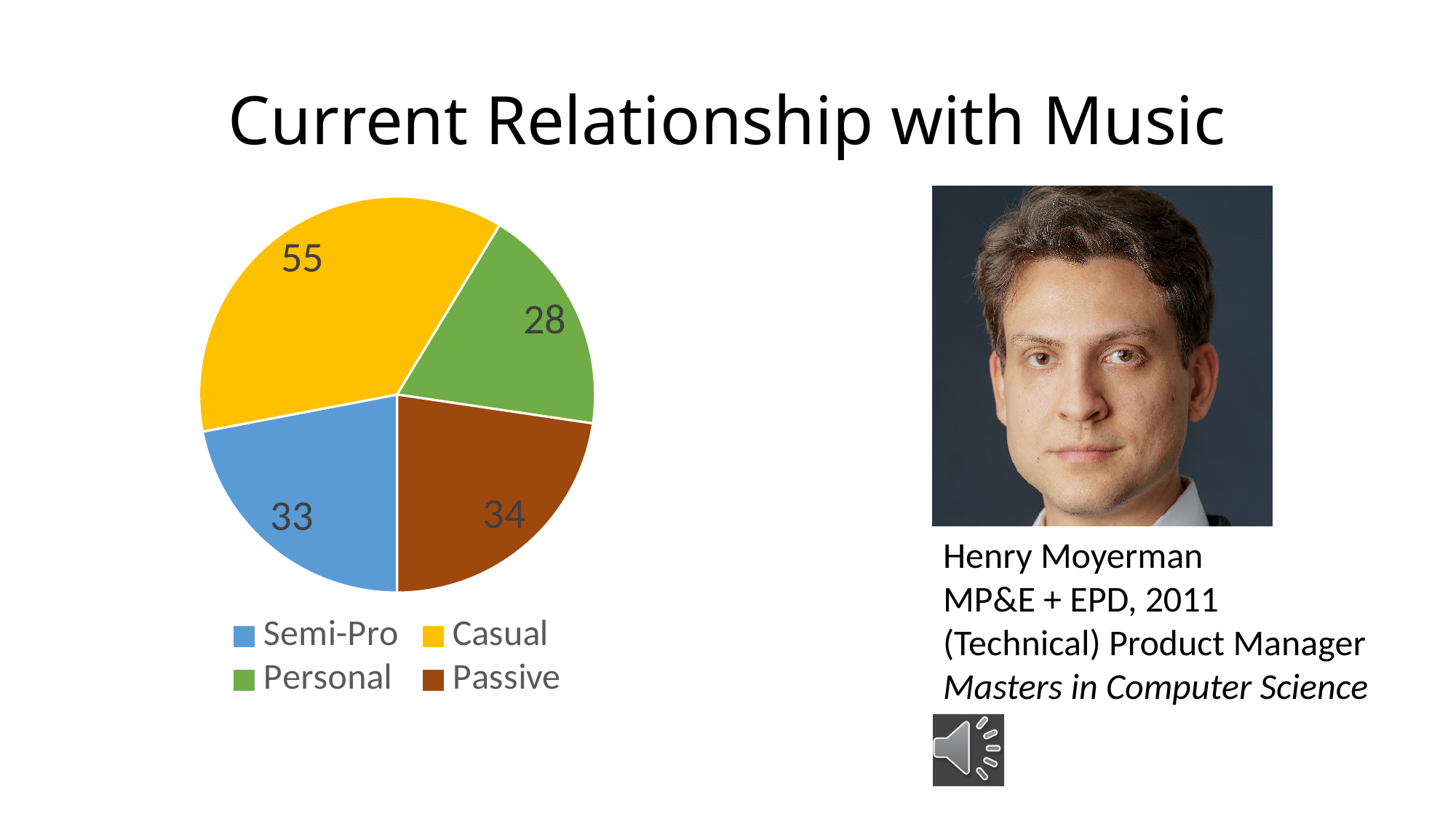
What is the value for Passive in the pie chart? 34 What is the difference between the Casual and Personal values? 27 Which category has the largest slice of the pie chart? Casual What share of the pie does the Semi-Pro slice represent? 22% What is the value for Casual in the pie chart? 55 Which category has the smallest slice of the pie chart? Personal What is the value for Personal in the pie chart? 28 What type of chart is shown on the slide? Pie chart Which is larger, the Casual slice or the Semi-Pro slice? Casual How many categories does the pie chart show? 4 What is the value for Semi-Pro in the pie chart? 33 What is the title of the chart on the slide? Current Relationship with Music